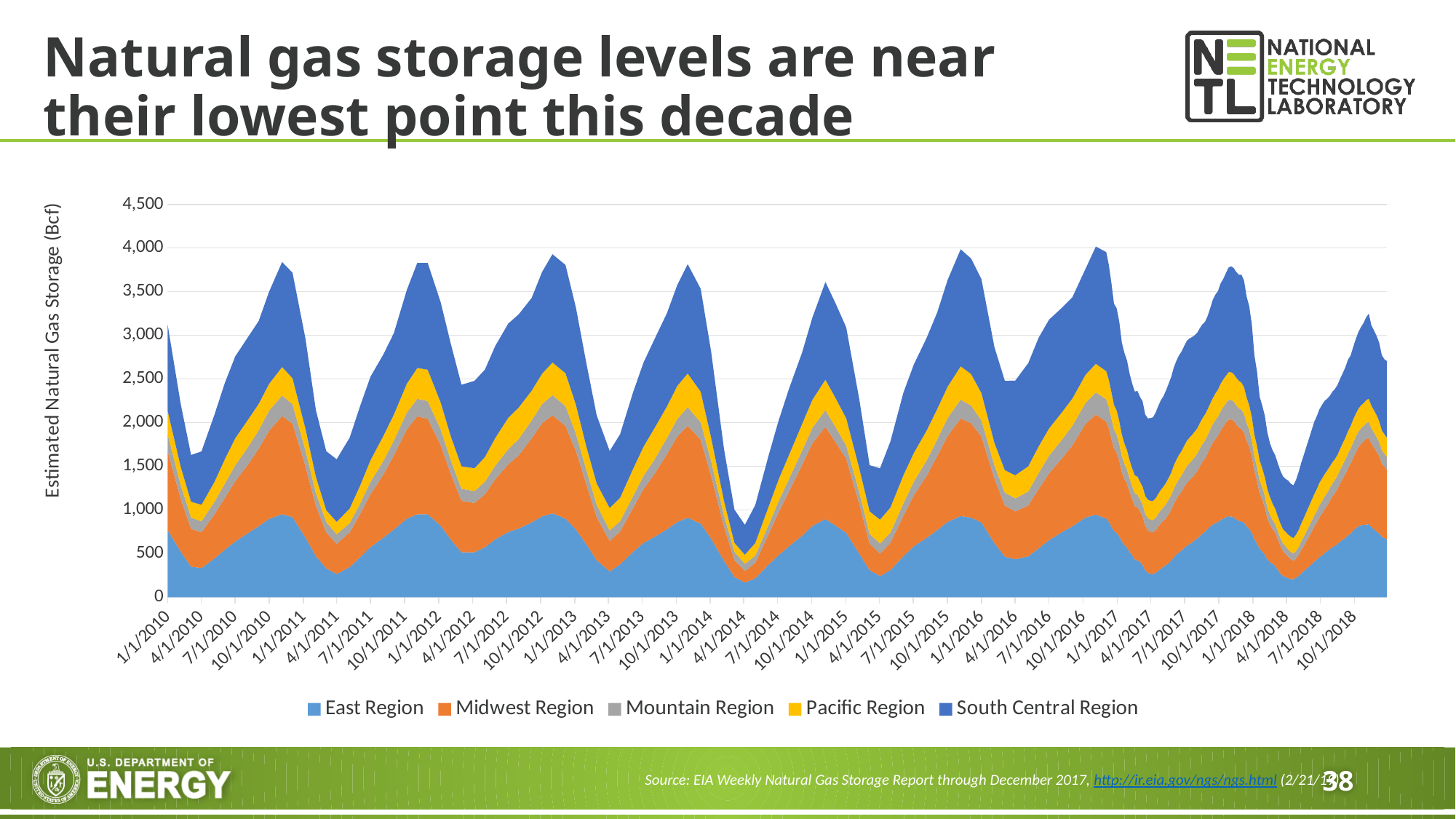
Is the total storage at the peak near 10/1/2012 greater or less than 3,500? greater Which region contributes the thinnest band to the stacked total? Mountain Region Which series is plotted at the bottom of the stack? East Region What is the label on the vertical axis? Estimated Natural Gas Storage (Bcf) Does the total storage rise or fall between 4/1/2018 and 10/1/2018? rise Is the total storage at the trough near 4/1/2018 greater or less than 1,000? greater How many date labels are shown on the x axis? 36 Does the total storage rise or fall between 10/1/2017 and 4/1/2018? fall Is the total storage at the trough near 4/1/2014 greater or less than 1,000? less What kind of chart is shown on the slide? Stacked area chart How many series does the legend list? 5 Which series is plotted at the top of the stack? South Central Region